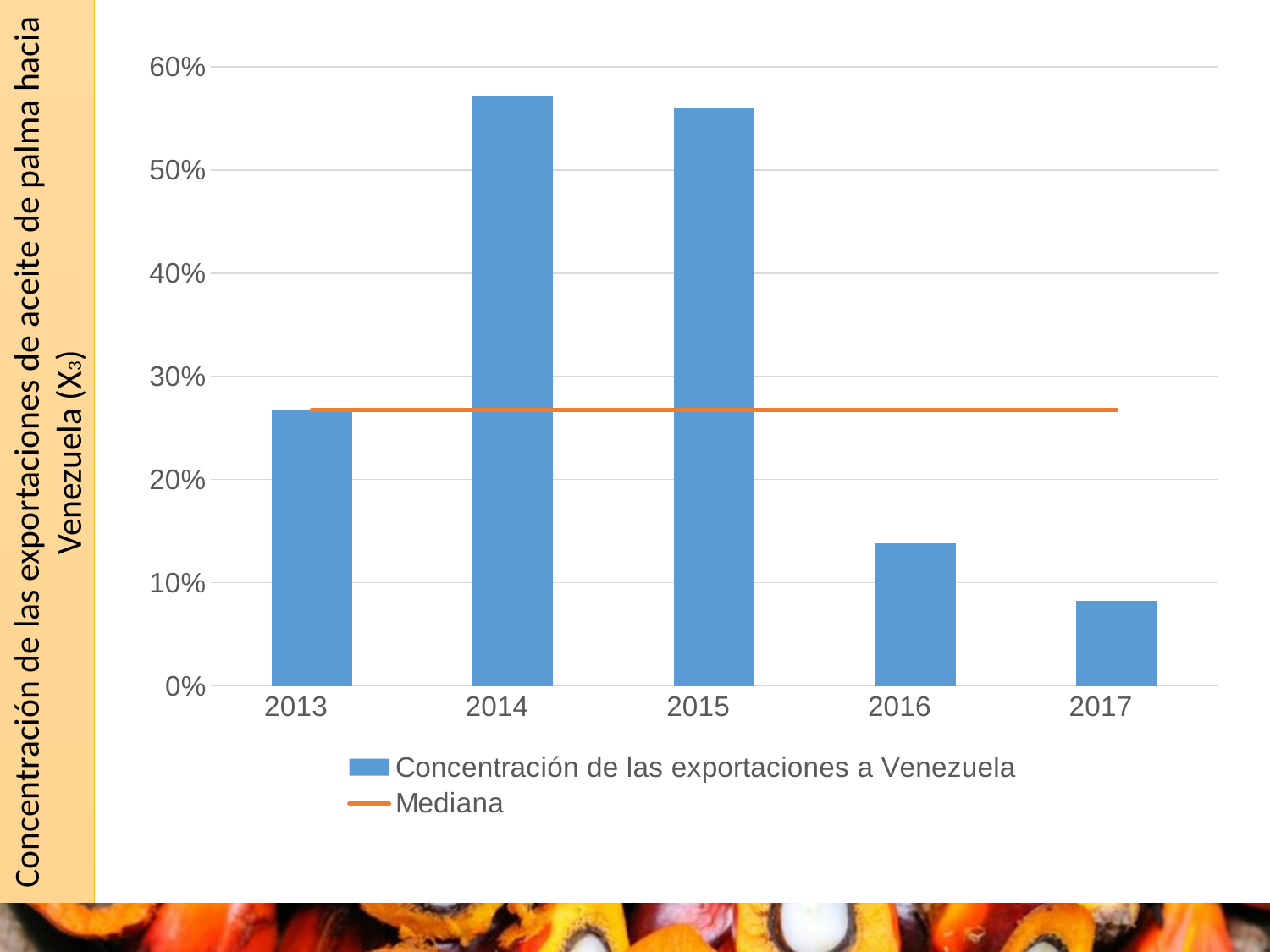
Do the values rise or fall from 2015 to 2017? fall Which is larger, the value for 2014 or the value for 2016? 2014 Is the value for 2014 greater or less than 50%? greater Is the value for 2013 greater or less than 30%? less How many years are shown on the x axis? 5 What is the legend label for the blue bars? Concentración de las exportaciones a Venezuela What kind of chart is shown on the slide? combination bar and line chart What does the orange line in the chart represent, according to the legend? Mediana Which year has the lowest concentration of exports to Venezuela? 2017 Is the value for 2017 greater or less than 10%? less How many series does the legend list? 2